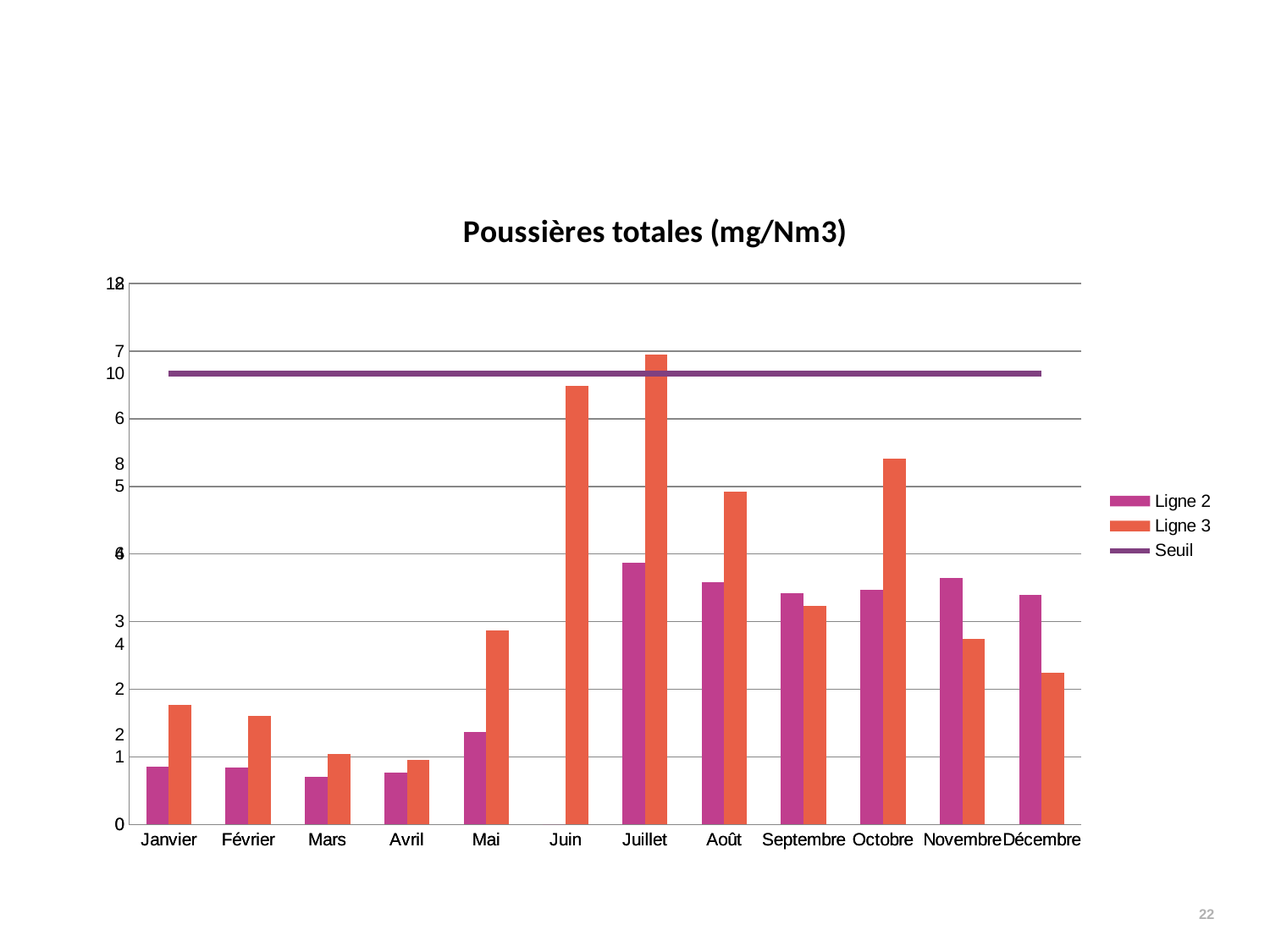
How many months are shown on the x axis? 12 Which is larger in Décembre, Ligne 2 or Ligne 3? Ligne 2 Which month has no Ligne 2 bar? Juin What is the title of the chart? Poussières totales (mg/Nm3) Which month has the highest Ligne 2 value? Juillet What kind of chart is shown on the slide? combination bar and line chart Which is larger in Mai, Ligne 2 or Ligne 3? Ligne 3 In which month is the Ligne 3 bar above the Seuil line? Juillet Which is larger for Ligne 3, Juin or Janvier? Juin Which month has the highest Ligne 3 value? Juillet Do the Ligne 3 values rise or fall from Janvier to Avril? fall How many series does the legend list? 3